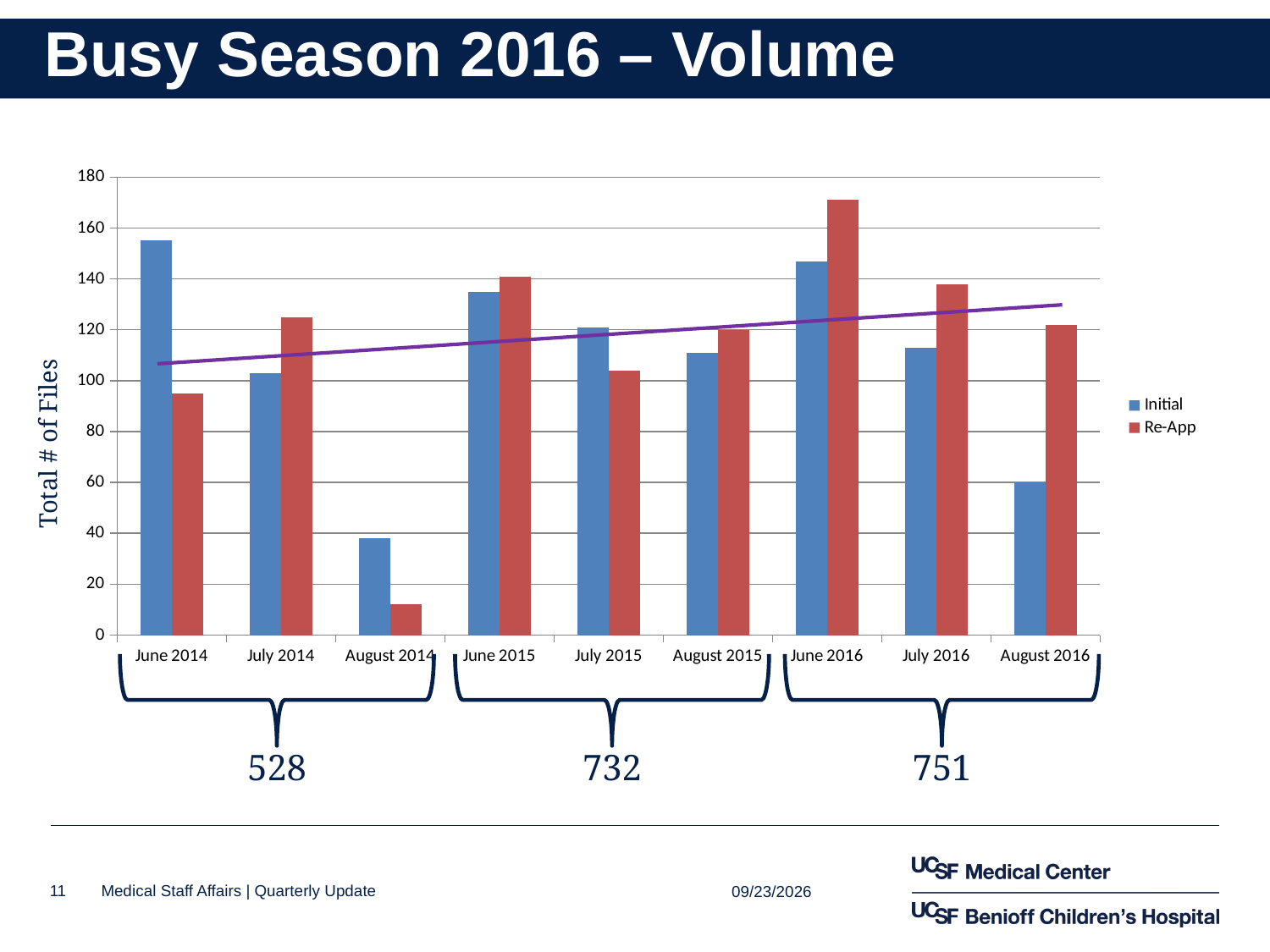
How many series does the legend list? 2 Does the purple trend line rise or fall from left to right? rises Is the Re-App value for June 2016 greater or less than 160? greater Is the Initial value for June 2014 greater or less than 140? greater In August 2016, which is larger, the Initial value or the Re-App value? Re-App What total is printed beneath the bracket grouping the 2016 months? 751 Which month has the lowest Re-App value? August 2014 How many month categories are shown on the x axis? 9 Is the Re-App value for August 2014 greater or less than 20? less Which month has the highest Re-App value? June 2016 What kind of chart is shown on the slide? bar chart Which month has the lowest Initial value? August 2014